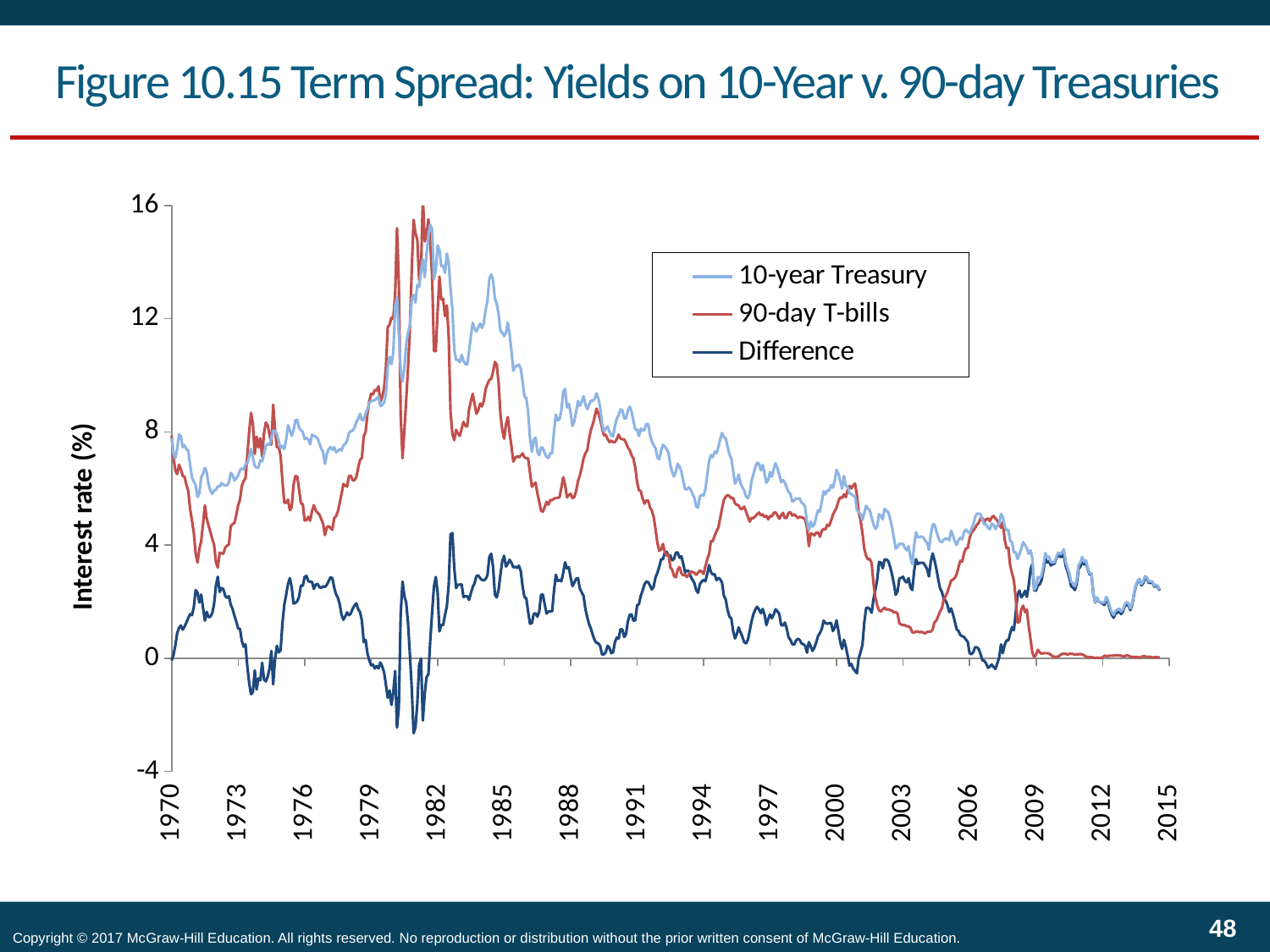
In 2012, which is higher: 10-year Treasury or 90-day T-bills? 10-year Treasury Is the value for 10-year Treasury in 2015 greater or less than 4? less Is the lowest value of the Difference series around 1980 greater or less than 0? less Is the value for 90-day T-bills in 2012 greater or less than 4? less Which series reaches the lowest value on the chart? Difference What is the title of the chart? Figure 10.15 Term Spread: Yields on 10-Year v. 90-day Treasuries Does the 10-year Treasury series rise or fall from 1985 to 2015? fall How many series does the legend list? 3 What is the label on the y axis? Interest rate (%) What kind of chart is shown on the slide? line chart